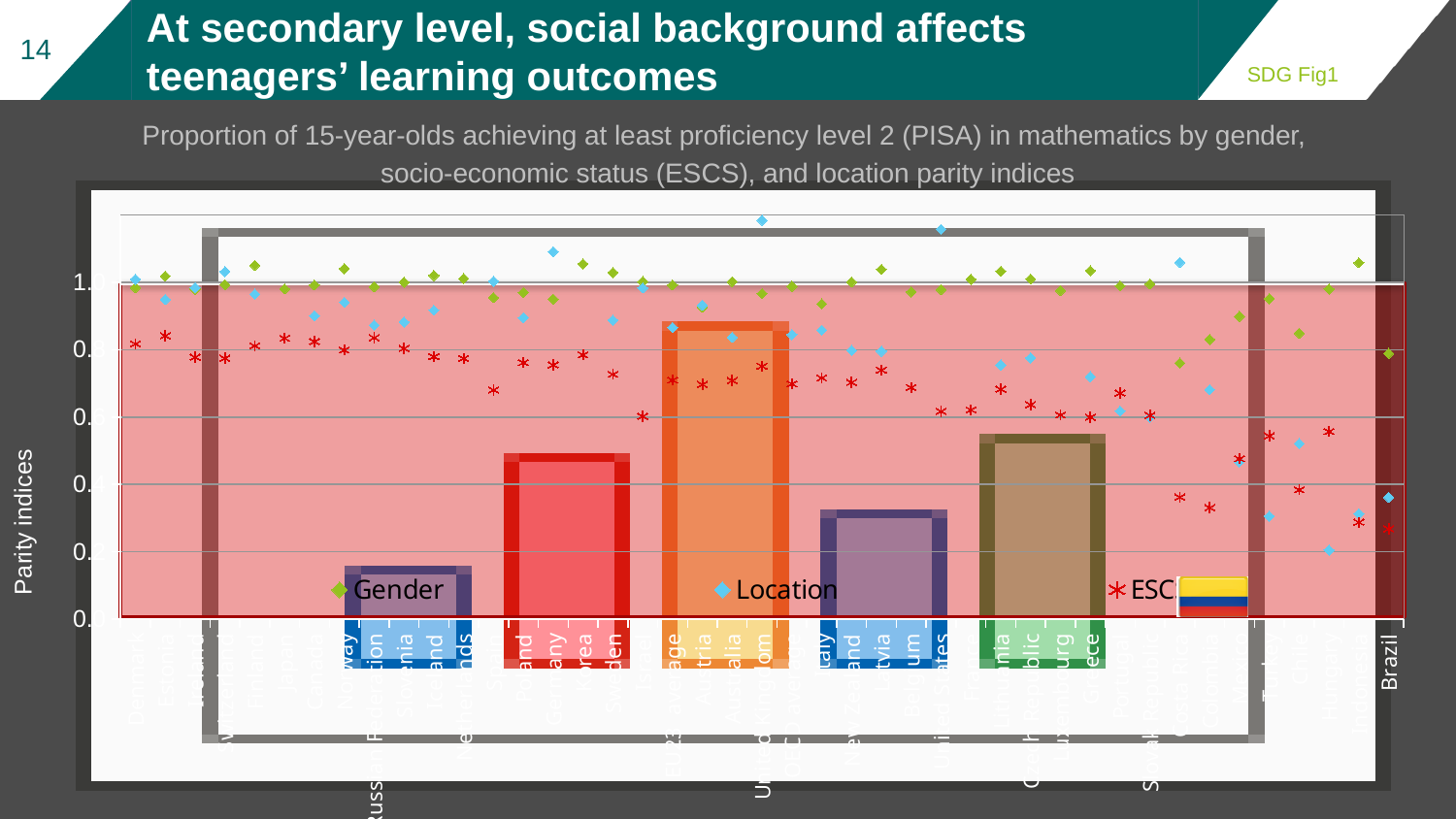
How many series does the legend list? 3 Is the Location value for Brazil greater or less than 0.4? less Is the Gender value for Brazil greater or less than 0.6? greater What is the title of the vertical axis? Parity indices What is the highest tick value shown on the vertical axis? 1.0 Which series generally has the lowest parity index values across the countries? ESCS Is the ESCS value for Brazil greater or less than 0.4? less Do the ESCS parity index values generally rise or fall moving from left to right along the x axis? fall What are the three series named in the legend? Gender, Location, ESCS For Brazil, which is larger: the Gender parity index or the Location parity index? Gender